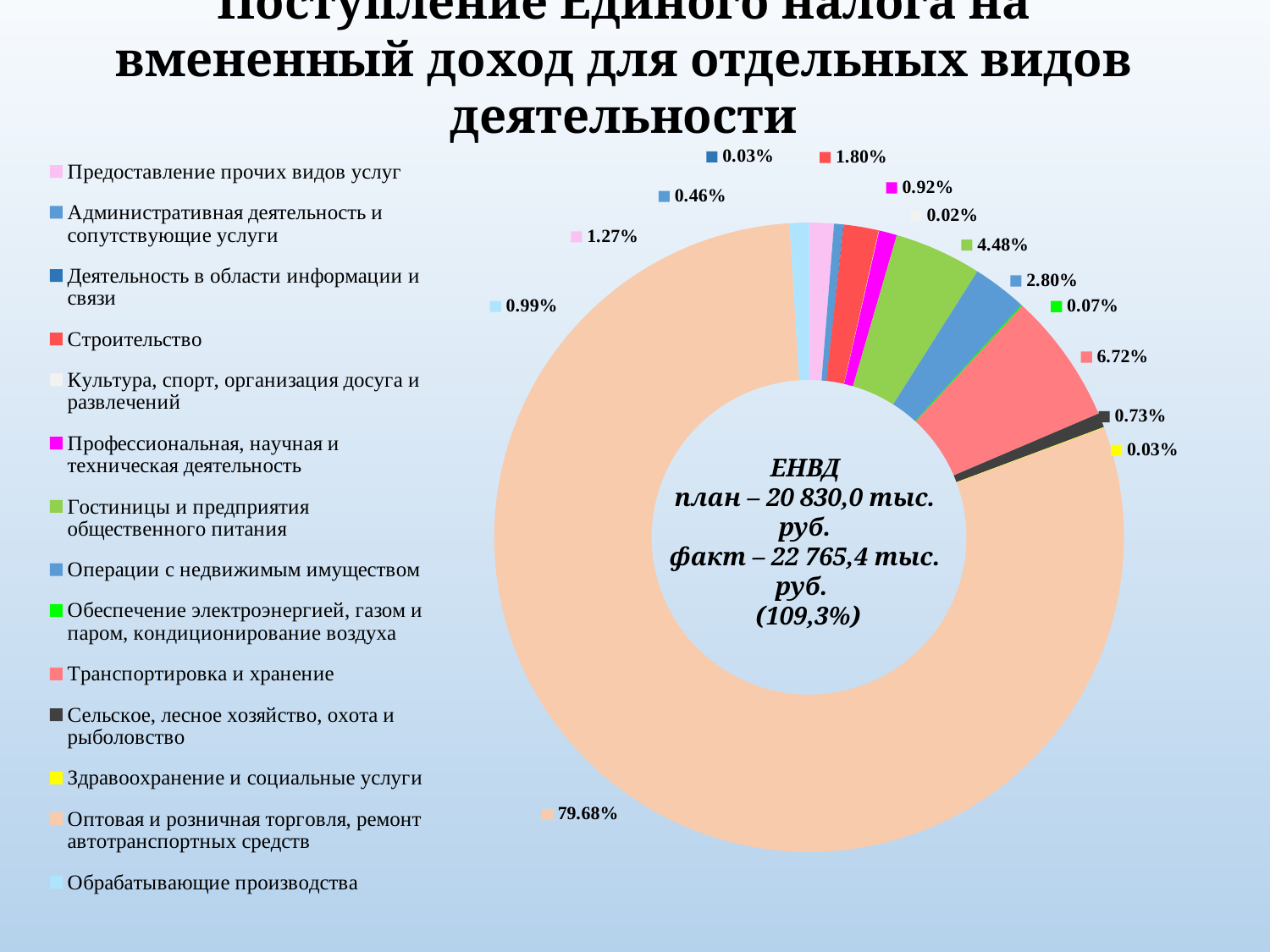
Which is larger: the share of "Операции с недвижимым имуществом" or the share of "Строительство"? Операции с недвижимым имуществом What is the difference between the shares of "Транспортировка и хранение" and "Гостиницы и предприятия общественного питания"? 2.24% What is the value shown for "Гостиницы и предприятия общественного питания"? 4.48% Which category has the smallest share of the chart? Культура, спорт, организация досуга и развлечений How many categories does the legend of the chart list? 14 What share of the chart does "Оптовая и розничная торговля, ремонт автотранспортных средств" account for? 79.68% What is the value shown for "Строительство"? 1.80% Which category has the largest share of the chart? Оптовая и розничная торговля, ремонт автотранспортных средств What is the value shown for "Транспортировка и хранение"? 6.72% What kind of chart is shown on the slide? Doughnut (pie) chart What is the planned (план) amount of ЕНВД shown in the centre of the chart? 20 830,0 тыс. руб. What is the value shown for "Операции с недвижимым имуществом"? 2.80%